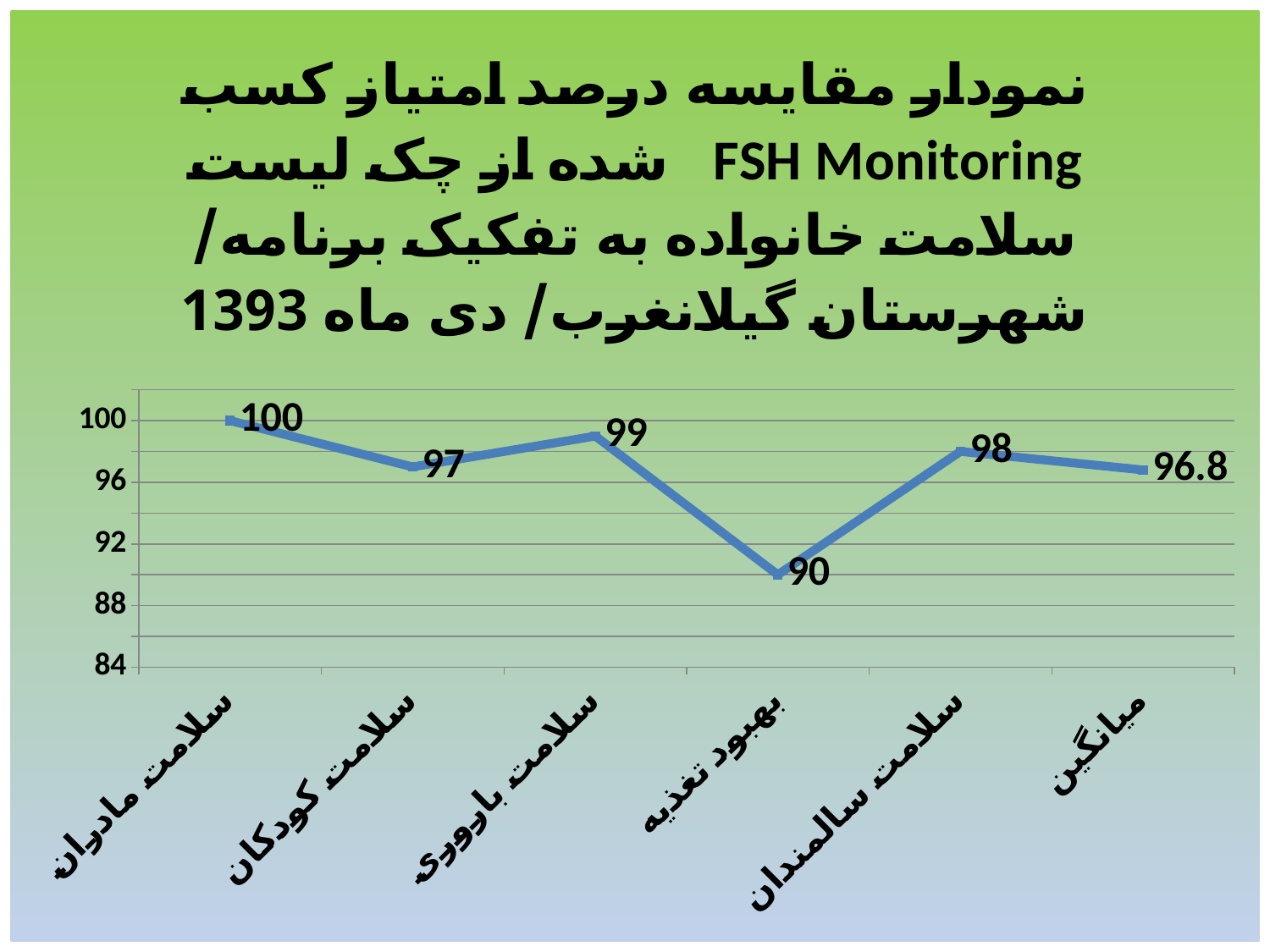
How many categories are plotted on the x axis? 6 What is the value for سلامت سالمندان? 98 What type of chart is shown on the slide? line chart What is the difference between the values for سلامت مادران and میانگین? 3.2 What is the value for بهبود تغذیه? 90 Which category has the highest value? سلامت مادران What is the value for سلامت مادران? 100 What is the value for میانگین? 96.8 Which category has the lowest value? بهبود تغذیه Which is larger, the value for سلامت کودکان or the value for سلامت سالمندان? سلامت سالمندان What is the difference between the values for سلامت باروری and بهبود تغذیه? 9 Is the value for بهبود تغذیه greater or less than 92? less